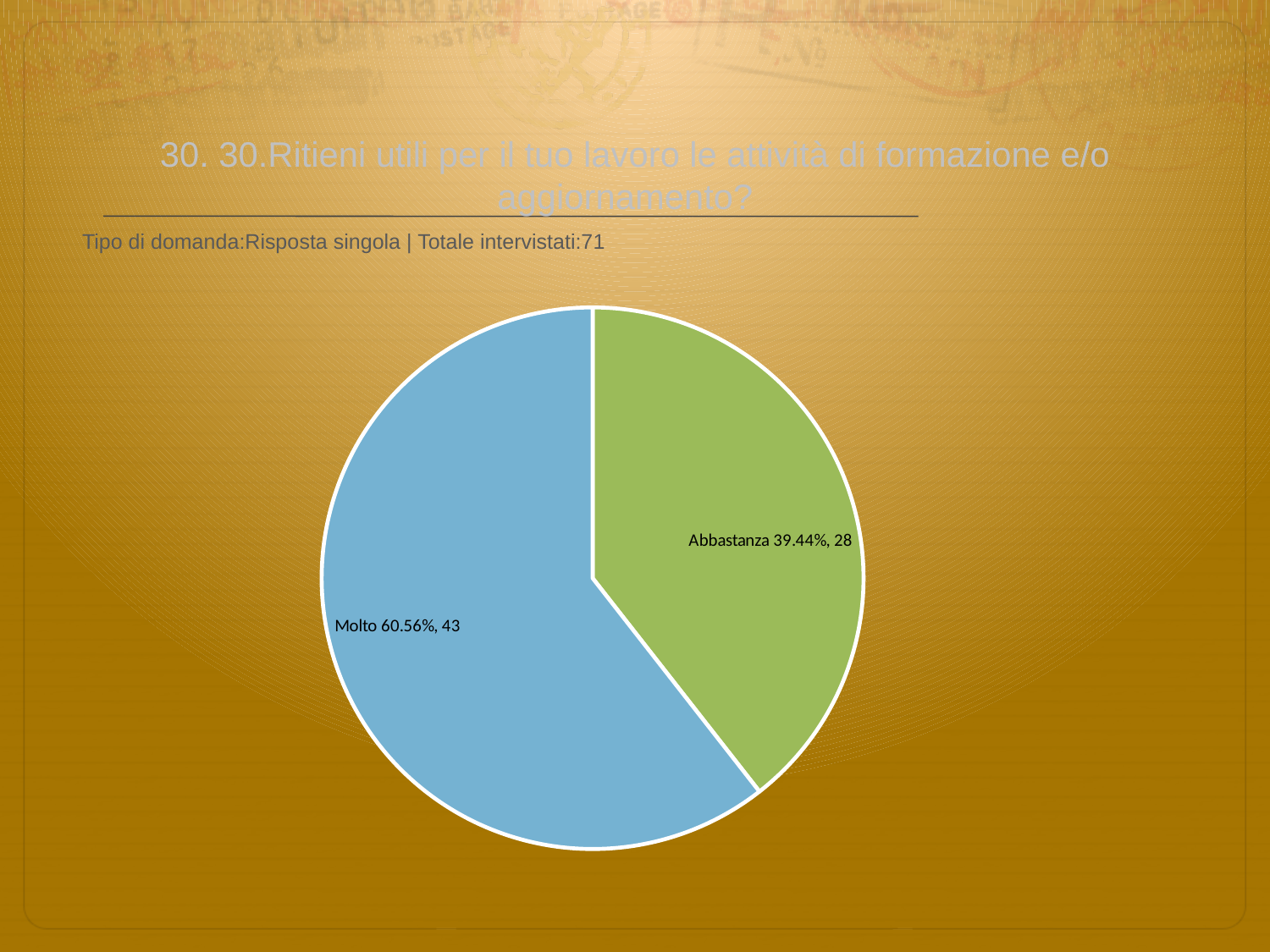
What colour is the Molto slice? blue What is the difference in respondent counts between Molto and Abbastanza? 15 How many slices does the pie chart have? 2 How many respondents answered Abbastanza? 28 How many respondents answered Molto? 43 Which slice is the smallest? Abbastanza What kind of chart is shown on the slide? pie chart Which slice is the largest? Molto What percentage share does the Abbastanza slice have? 39.44% What percentage share does the Molto slice have? 60.56% What is the total number of respondents across both slices? 71 Which has more respondents, Molto or Abbastanza? Molto